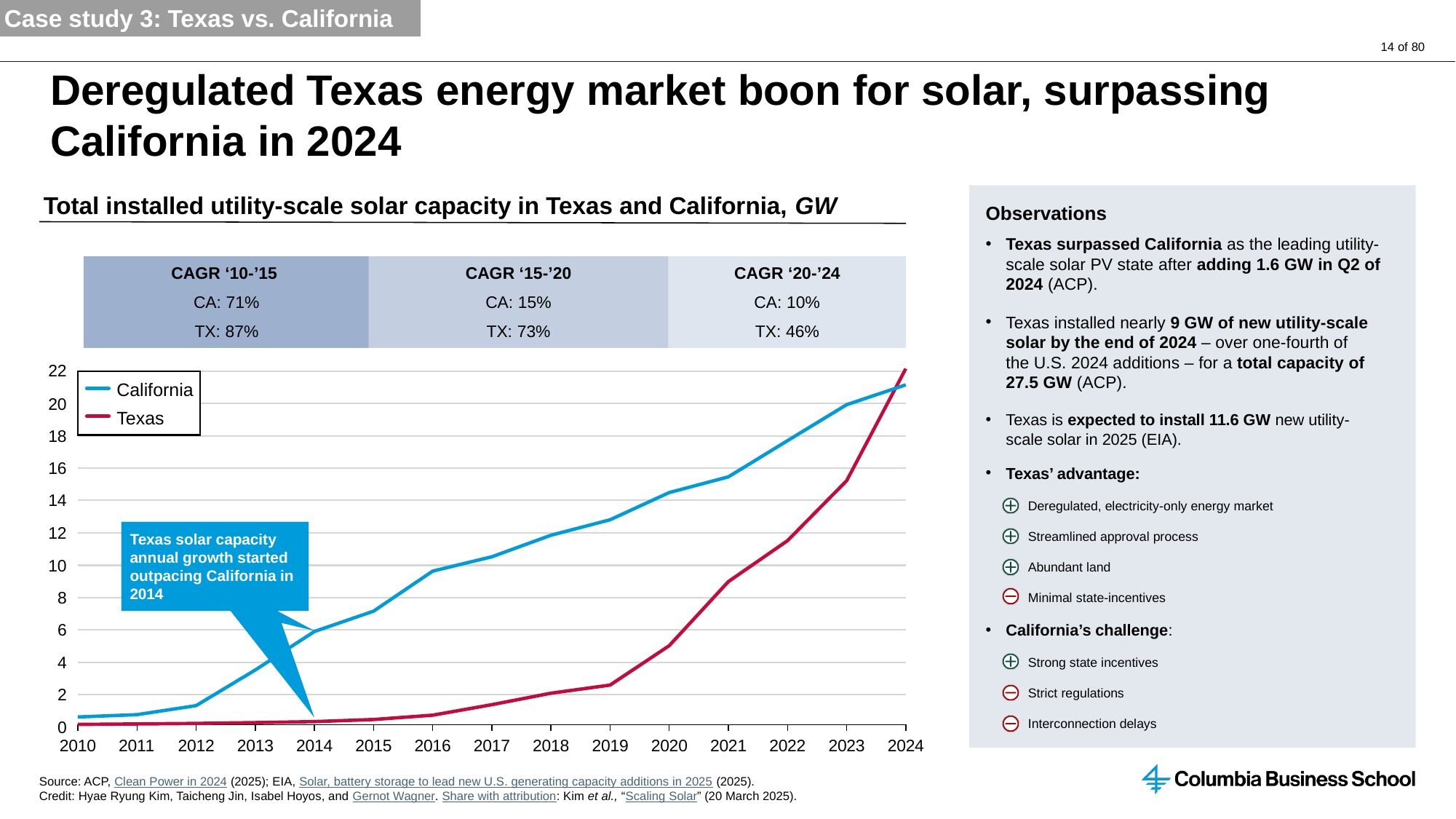
How many series does the chart legend list? 2 What is the unit of the values plotted in the chart, according to its title? GW In 2024, which series has the larger value, California or Texas? Texas What is the CAGR for Texas over 2010-2015 shown above the chart? 87% Which two series are listed in the chart legend? California and Texas What is the CAGR for Texas over 2020-2024 shown above the chart? 46% Is the value for Texas in 2019 greater or less than 4? less What is the CAGR for California over 2015-2020 shown above the chart? 15% Does the Texas line rise or fall from 2010 to 2024? rise How many years are shown along the x axis of the chart? 15 In 2020, which series has the larger value, California or Texas? California What kind of chart is shown on the slide? line chart